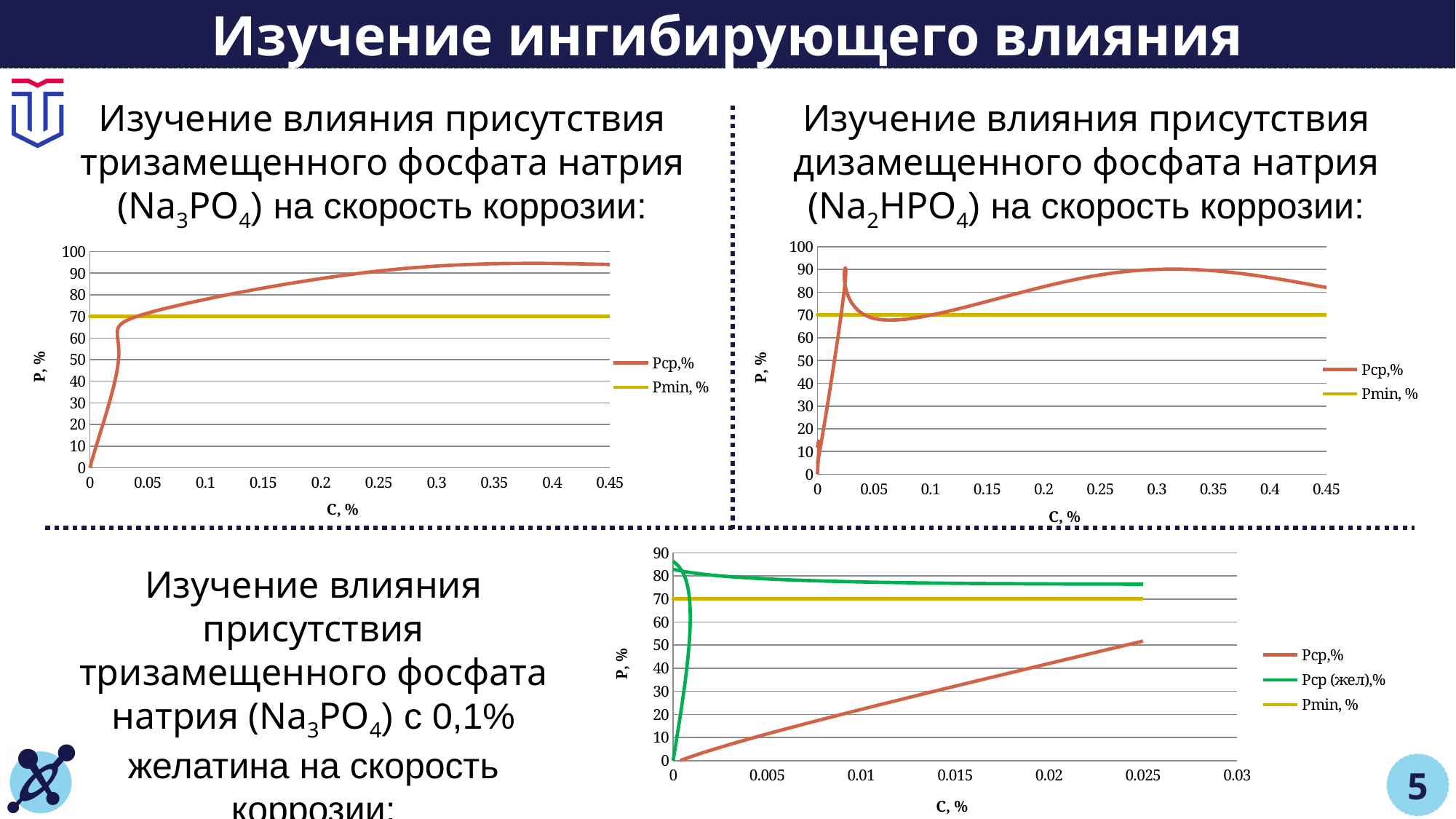
In the top-right chart (Na2HPO4), is the Pcp,% value at C = 0.45 greater or less than 90? less In the top-right chart (Na2HPO4), is the Pcp,% value at C = 0.3 greater or less than 80? greater In the top-left chart (Na3PO4), is the Pcp,% value at C = 0.45 greater or less than 80? greater In the bottom chart (Na3PO4 with 0.1% gelatin), which series is higher at C = 0.025: Pcp,% or Pcp (жел),%? Pcp (жел),% In the top-left chart (Na3PO4), what value does the Pmin, % line sit at? 70 How many series does the legend of the top-left chart (Na3PO4) list? 2 What are the legend entries of the bottom chart (Na3PO4 with 0.1% gelatin)? Pcp,%; Pcp (жел),%; Pmin, % In the bottom chart (Na3PO4 with 0.1% gelatin), does the Pcp,% series rise or fall as C increases from 0 to 0.025? rise What kind of chart is the top-left chart (Na3PO4 on corrosion rate)? line chart What is the label of the x axis on the top-right chart (Na2HPO4)? C, % How many series does the legend of the bottom chart (Na3PO4 with 0.1% gelatin) list? 3